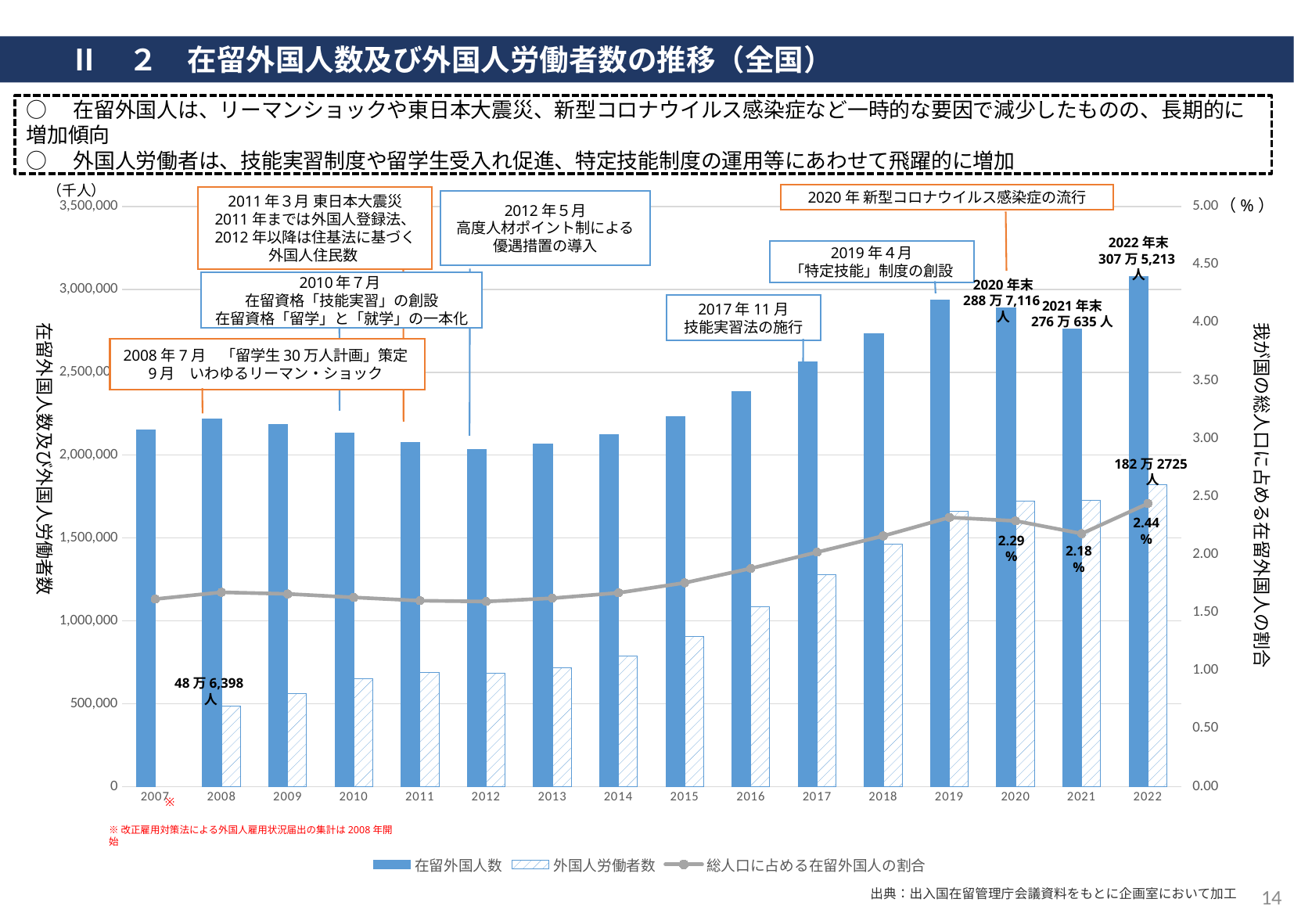
What is the difference between the 在留外国人数 at the end of 2020 and at the end of 2021? 126,481人 What is the number of 在留外国人数 at the end of 2020? 288万7,116人 What is the number of 外国人労働者数 in 2008? 48万6,398人 Is the value for 外国人労働者数 in 2016 greater or less than 1,500,000? less What is the number of 在留外国人数 at the end of 2022? 307万5,213人 What is the 総人口に占める在留外国人の割合 in 2021? 2.18% Which is larger, the 在留外国人数 in 2020 or in 2021? 2020 How many years are shown on the x axis? 16 What kind of chart is shown on the slide? A combined bar and line chart In which year is the 在留外国人数 highest? 2022 What is the number of 外国人労働者数 in 2022? 182万2725人 How many series does the legend list? 3